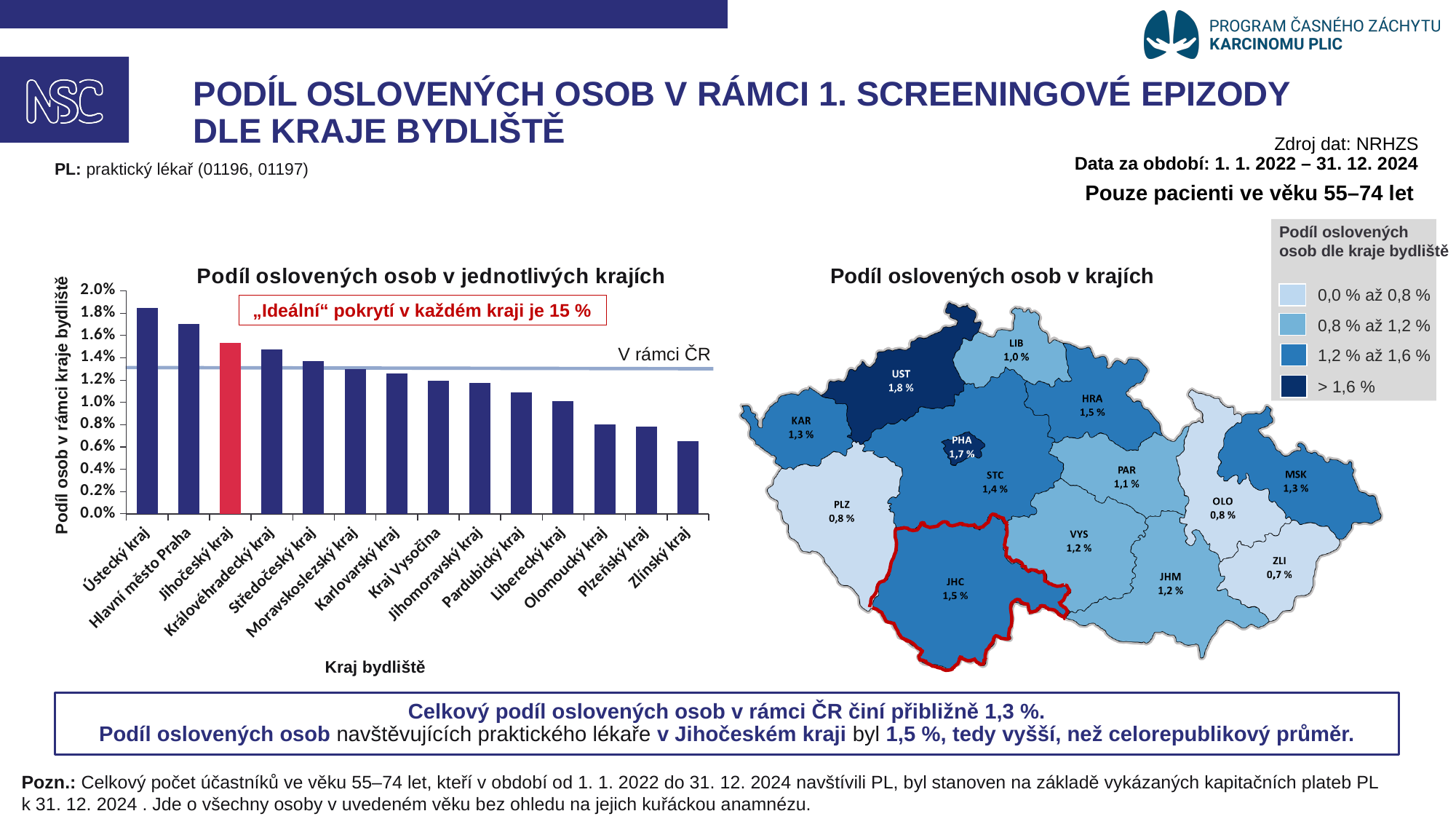
In the map 'Podíl oslovených osob v krajích', what value is shown for PLZ? 0,8 % In the map 'Podíl oslovených osob v krajích', what is the difference between the values for UST and ZLI? 1,1 % In the bar chart 'Podíl oslovených osob v jednotlivých krajích', is the value for Zlínský kraj greater or less than 0.8%? less What kind of chart is 'Podíl oslovených osob v jednotlivých krajích'? Bar chart In the bar chart 'Podíl oslovených osob v jednotlivých krajích', do the values rise or fall from left to right along the x axis? fall In the map 'Podíl oslovených osob v krajích', what value is shown for JHC? 1,5 % In the bar chart 'Podíl oslovených osob v jednotlivých krajích', which region has the lowest value? Zlínský kraj How many regions are plotted in the bar chart 'Podíl oslovených osob v jednotlivých krajích'? 14 In the bar chart 'Podíl oslovených osob v jednotlivých krajích', is the value for Hlavní město Praha greater or less than 1.6%? greater In the bar chart 'Podíl oslovených osob v jednotlivých krajích', which region has the highest value? Ústecký kraj In the bar chart 'Podíl oslovených osob v jednotlivých krajích', which region's bar is highlighted in red? Jihočeský kraj